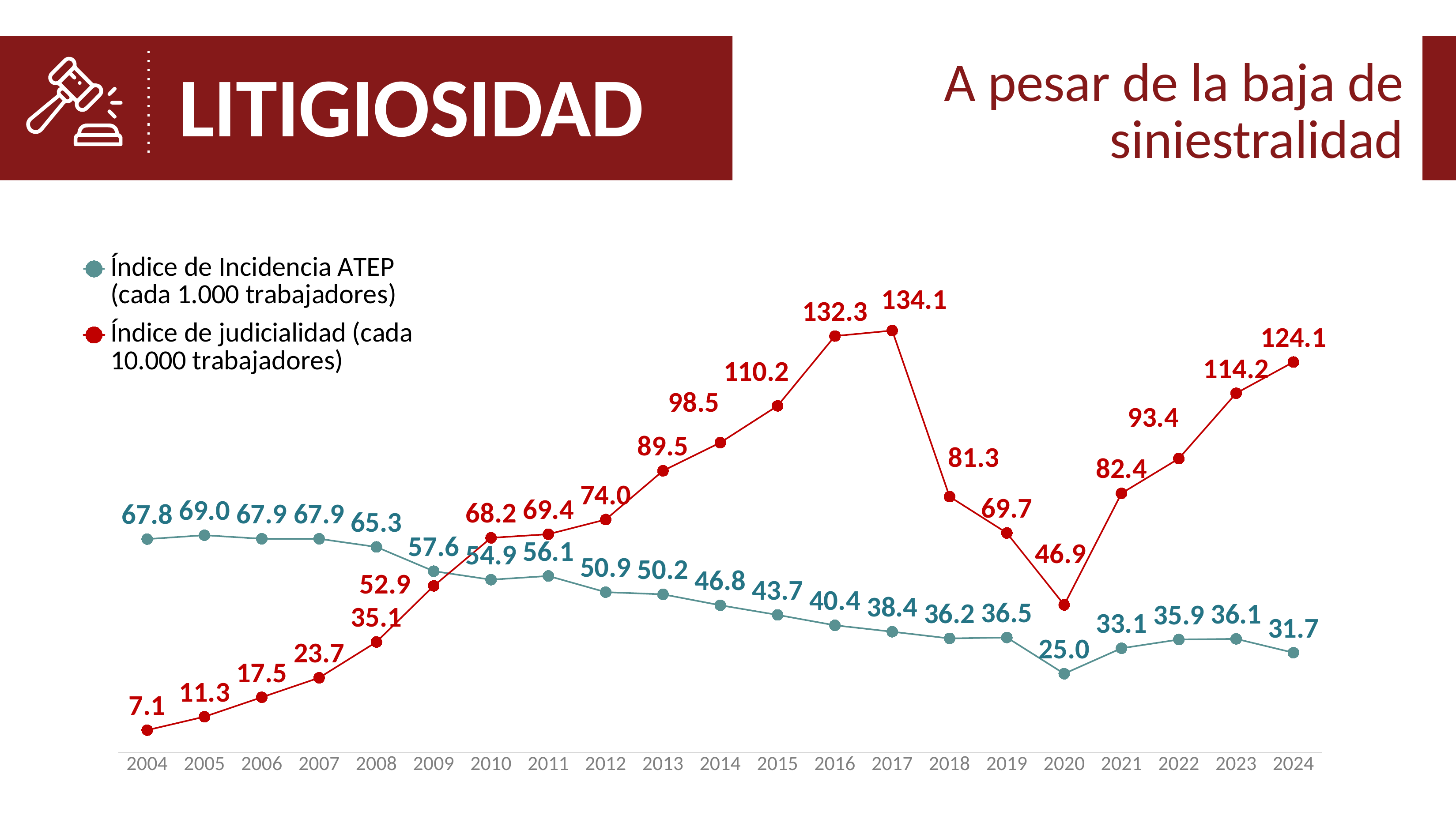
Which is larger in 2009: the Índice de Incidencia ATEP or the Índice de judicialidad? Índice de Incidencia ATEP What is the difference between the Índice de judicialidad in 2024 and in 2020? 77.2 How many series does the legend list? 2 What is the value of the Índice de judicialidad in 2004? 7.1 Does the Índice de Incidencia ATEP generally rise or fall from 2004 to 2024? Fall What is the value of the Índice de judicialidad in 2017? 134.1 In which year is the Índice de Incidencia ATEP at its lowest? 2020 What is the value of the Índice de Incidencia ATEP in 2020? 25.0 Which is larger in 2016: the Índice de Incidencia ATEP or the Índice de judicialidad? Índice de judicialidad How many years are shown on the x axis? 21 In which year does the Índice de judicialidad reach its highest value? 2017 What kind of chart is shown on the slide? Line chart